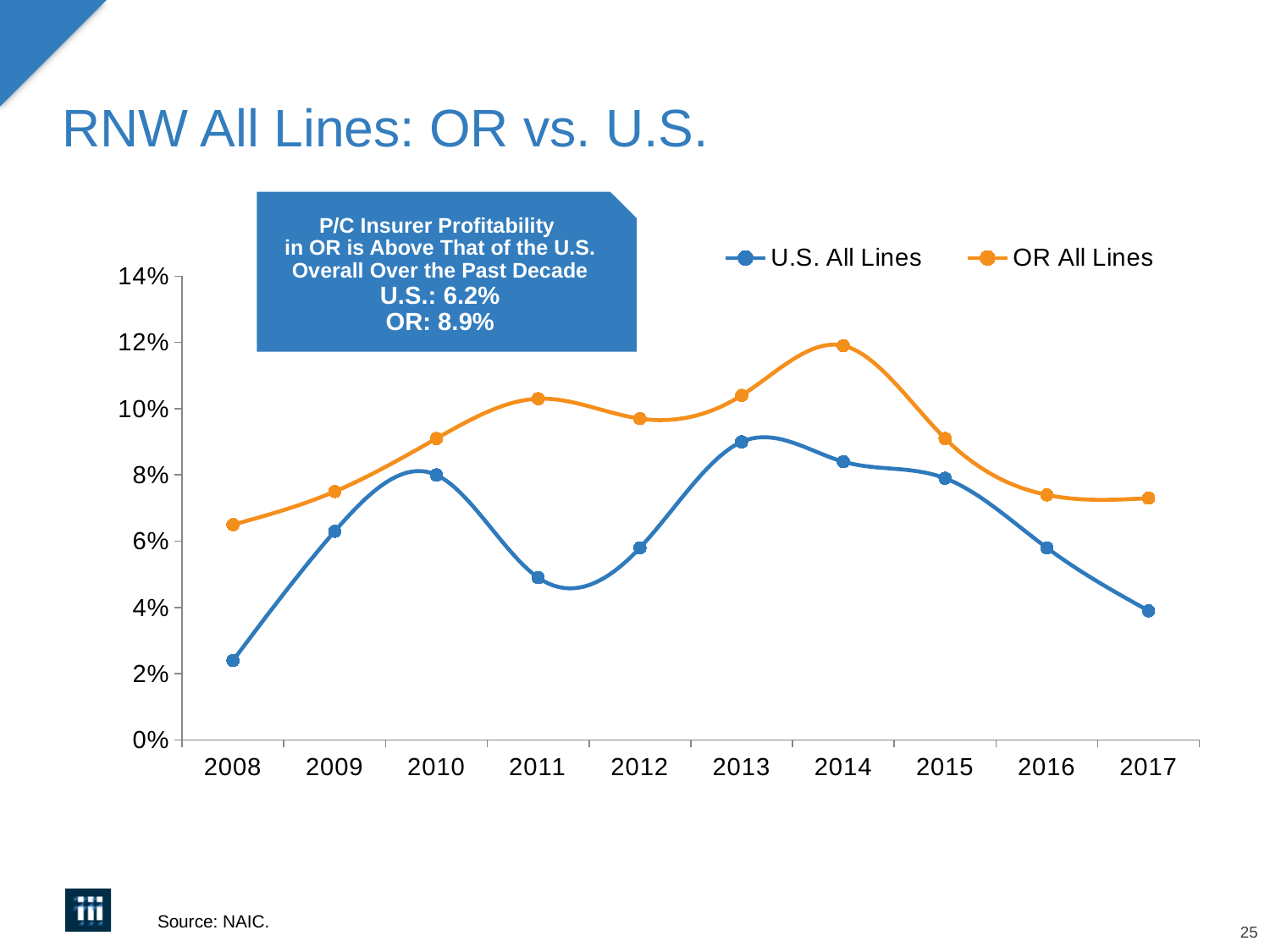
What kind of chart is shown on the slide? line chart In which year is the U.S. All Lines value lowest? 2008 In which year is the U.S. All Lines value highest? 2013 According to the callout box, what is the decade-average RNW for OR? 8.9% Is the U.S. All Lines value for 2011 greater or less than 6%? less Does the U.S. All Lines series rise or fall from 2013 to 2017? fall In 2012, which series has the larger value, U.S. All Lines or OR All Lines? OR All Lines Is the U.S. All Lines value for 2008 greater or less than 4%? less How many years are plotted along the x axis? 10 How many series does the legend list? 2 Is the OR All Lines value for 2014 greater or less than 10%? greater In which year is the OR All Lines value highest? 2014